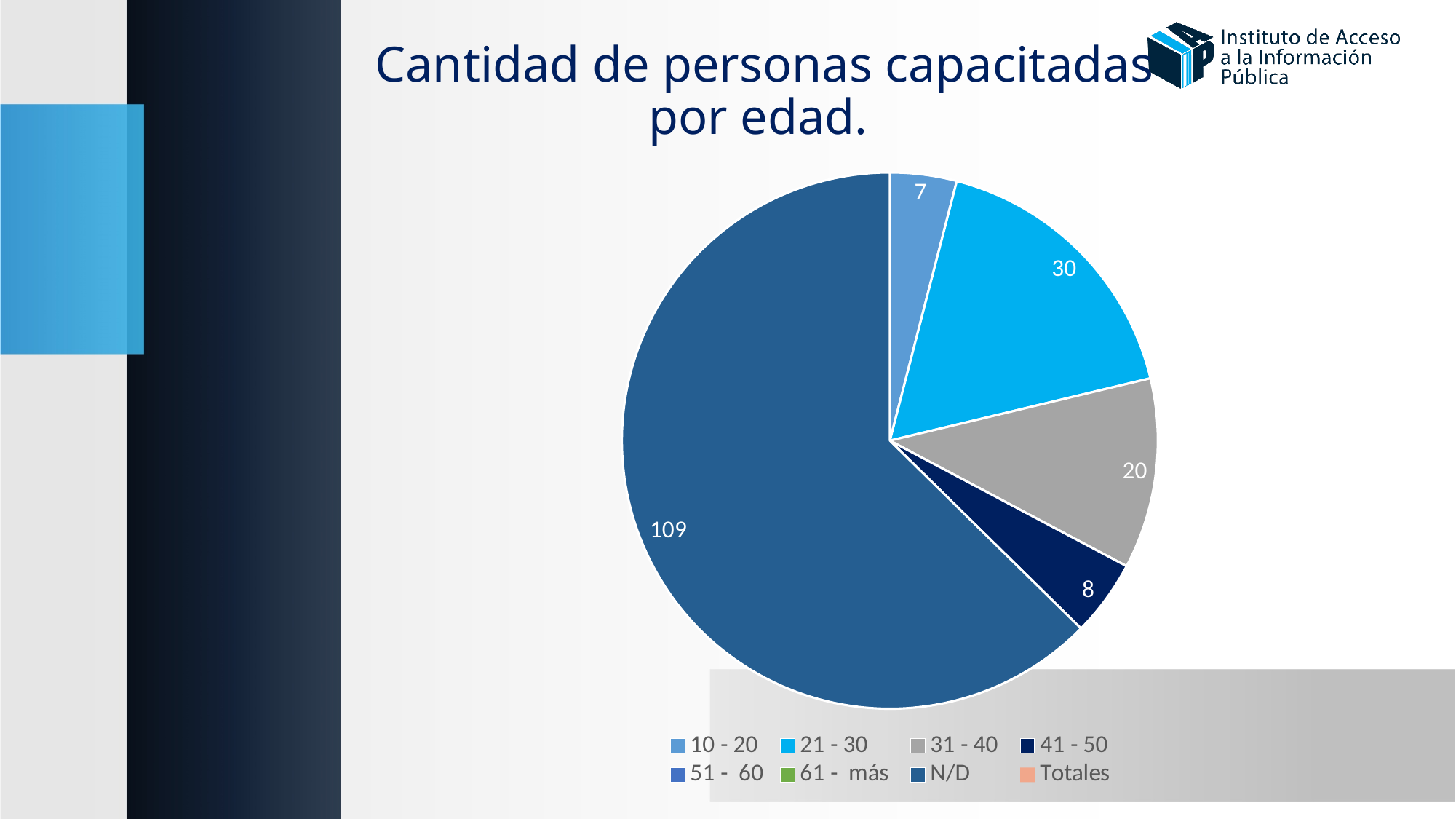
Which category has the largest slice of the pie? N/D How many slices with data labels are shown in the pie? 5 Which is larger, the value for 41 - 50 or the value for 10 - 20? 41 - 50 What type of chart is shown on the slide? pie chart How many entries does the legend list? 8 What is the difference between the values for 21 - 30 and 31 - 40? 10 What is the value for the N/D slice? 109 Which labelled slice has the smallest value? 10 - 20 What is the value for the 31 - 40 age group? 20 What is the value for the 21 - 30 age group? 30 What is the value for the 10 - 20 age group? 7 What is the value for the 41 - 50 age group? 8